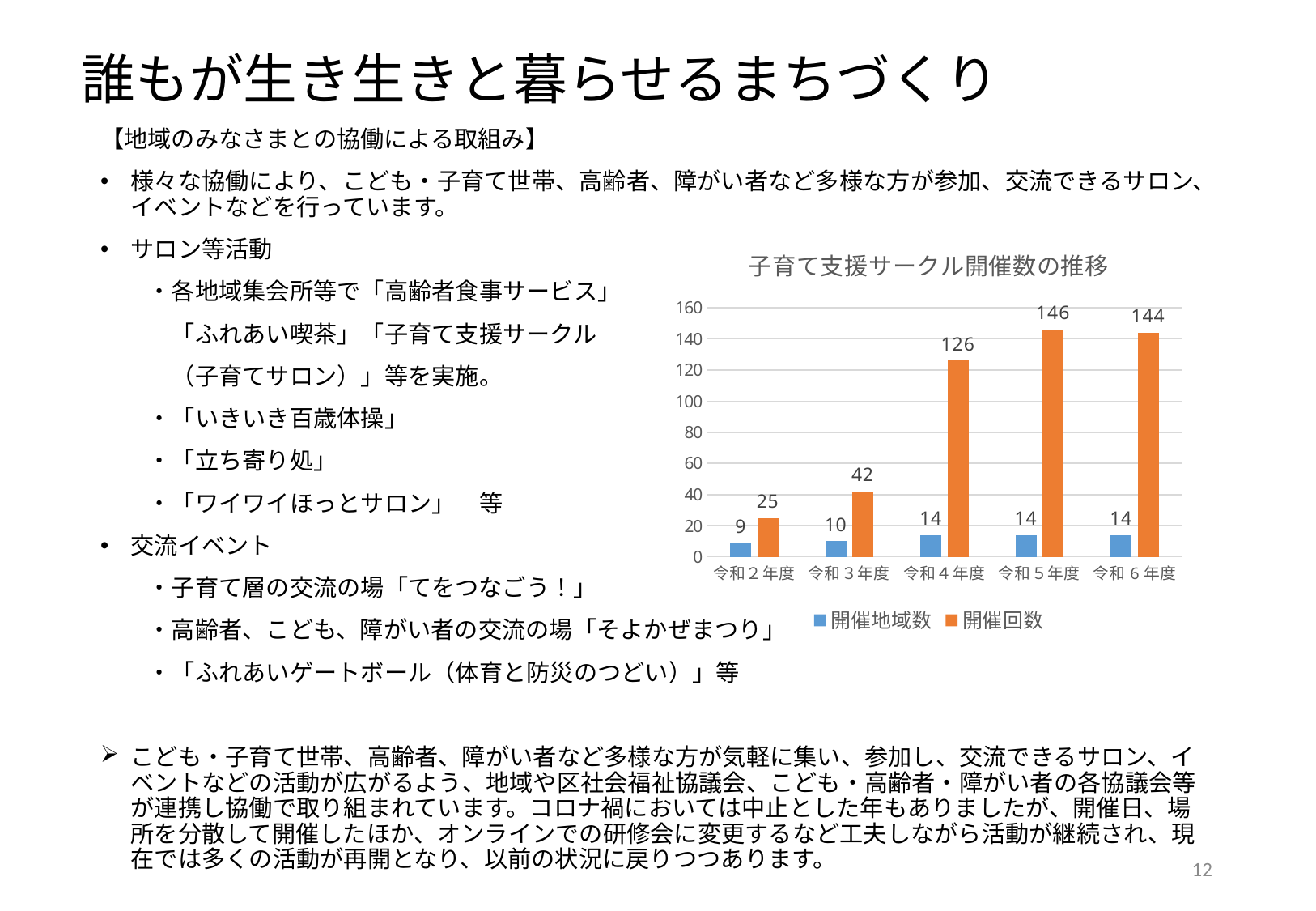
What is the value of 開催地域数 for 令和２年度? 9 Which is larger, the 開催回数 for 令和４年度 or for 令和６年度? 令和６年度 Which fiscal year has the highest 開催回数? 令和５年度 How many series does the legend list? 2 What is the value of 開催回数 for 令和３年度? 42 What is the title of the chart? 子育て支援サークル開催数の推移 What kind of chart is shown on the slide? Bar chart What is the value of 開催回数 for 令和４年度? 126 Which fiscal year has the lowest 開催回数? 令和２年度 What is the difference in 開催回数 between 令和５年度 and 令和６年度? 2 What is the difference in 開催回数 between 令和４年度 and 令和３年度? 84 How many fiscal years are shown on the x axis? 5